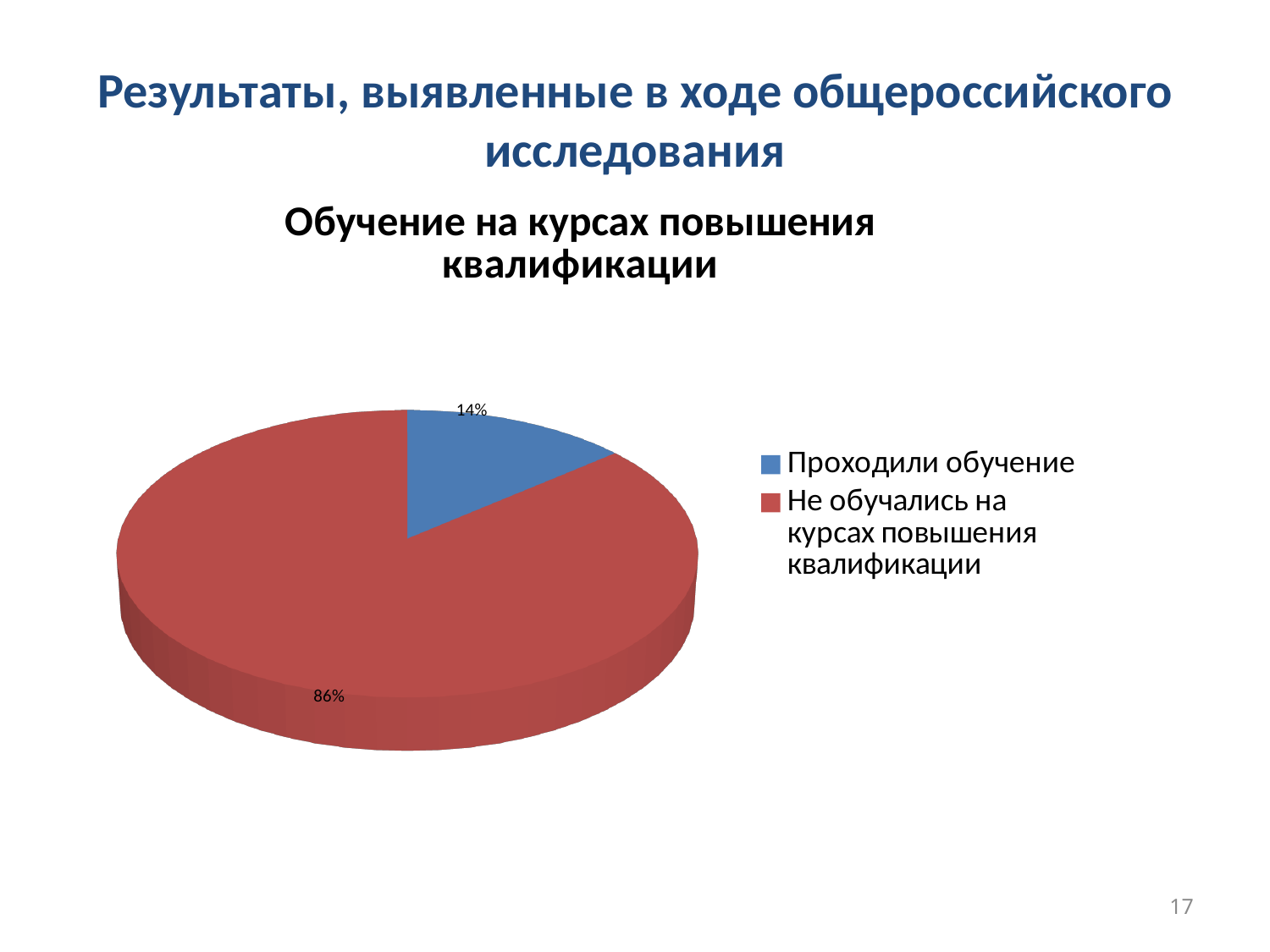
What colour is the slice for "Проходили обучение"? Blue What is the difference in percentage points between the two slices? 72 Which is larger: the share for "Проходили обучение" or for "Не обучались на курсах повышения квалификации"? Не обучались на курсах повышения квалификации How many slices does the pie chart have? 2 What is the title of the chart? Обучение на курсах повышения квалификации Which category has the largest slice of the pie? Не обучались на курсах повышения квалификации What kind of chart is shown on the slide? Pie chart Which category has the smallest slice of the pie? Проходили обучение What share of the pie is labelled for "Проходили обучение"? 14% What share of the pie is labelled for "Не обучались на курсах повышения квалификации"? 86% How many entries does the legend list? 2